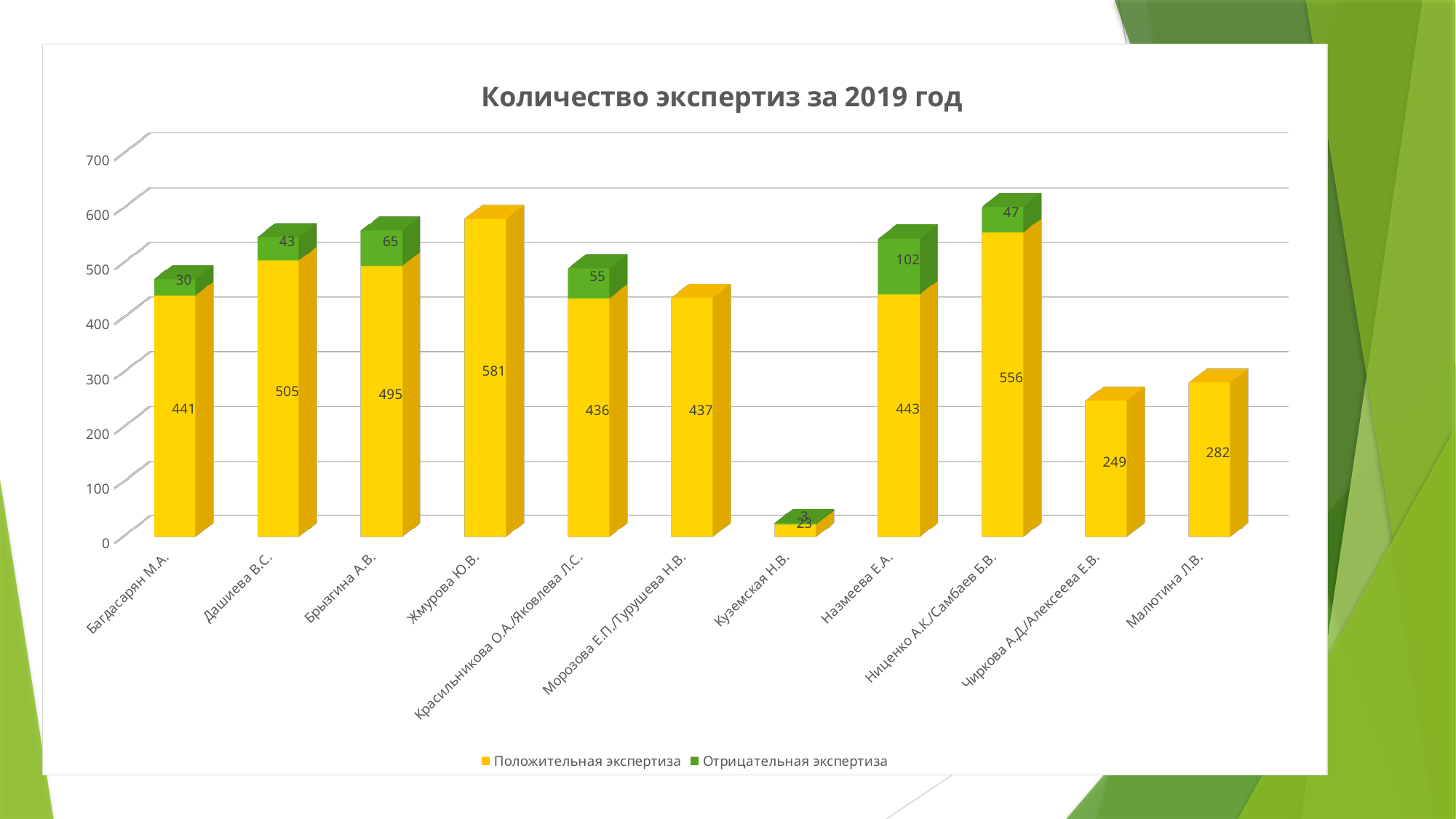
What is the difference between the Положительная экспертиза values for Дашиева В.С. and Брызгина А.В.? 10 What is the total of the stacked bar for Ниценко А.К./Самбаев Б.В.? 603 Which category has the highest value of Положительная экспертиза? Жмурова Ю.В. Which category has the highest value of Отрицательная экспертиза? Назмеева Е.А. What is the total of the stacked bar for Назмеева Е.А.? 545 What is the title of the chart? Количество экспертиз за 2019 год Which category has the lowest value of Положительная экспертиза? Куземская Н.В. Which is larger, the Положительная экспертиза value for Ниценко А.К./Самбаев Б.В. or for Дашиева В.С.? Ниценко А.К./Самбаев Б.В. What is the value of Отрицательная экспертиза for Назмеева Е.А.? 102 How many series does the legend list? 2 How many categories are shown on the x axis? 11 What is the value of Положительная экспертиза for Жмурова Ю.В.? 581